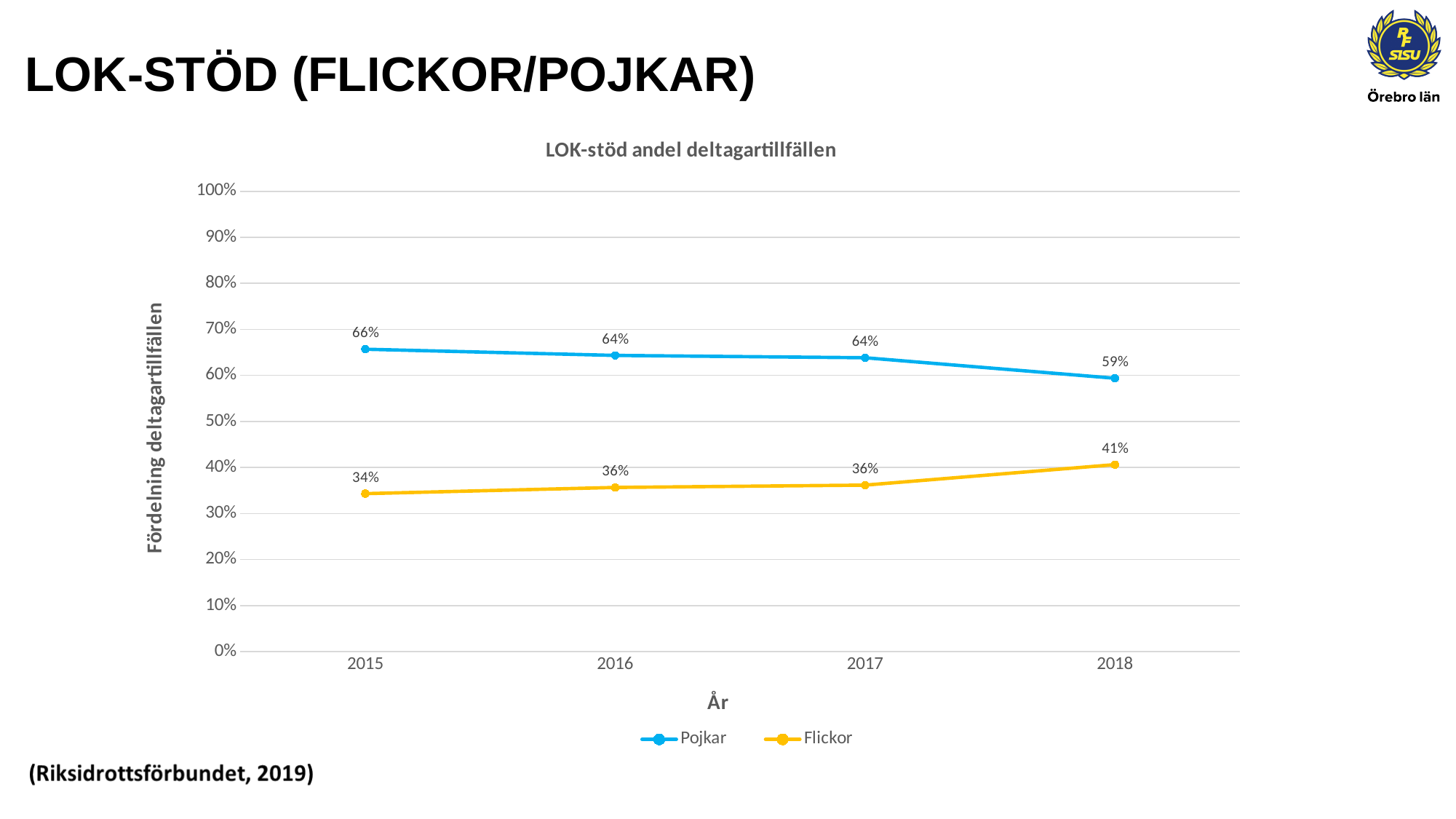
What is the value for Flickor in 2018? 41% What is the value for Pojkar in 2015? 66% What kind of chart is shown? Line chart Does the Flickor series rise or fall from 2015 to 2018? Rise In which year is the value for Pojkar lowest? 2018 Which series has the larger value in 2017, Pojkar or Flickor? Pojkar What is the difference between Pojkar and Flickor in 2018? 18% What is the value for Flickor in 2016? 36% What is the difference between the Pojkar value in 2015 and in 2018? 7% In which year is the value for Flickor highest? 2018 How many years are shown on the x axis? 4 How many series does the legend list? 2